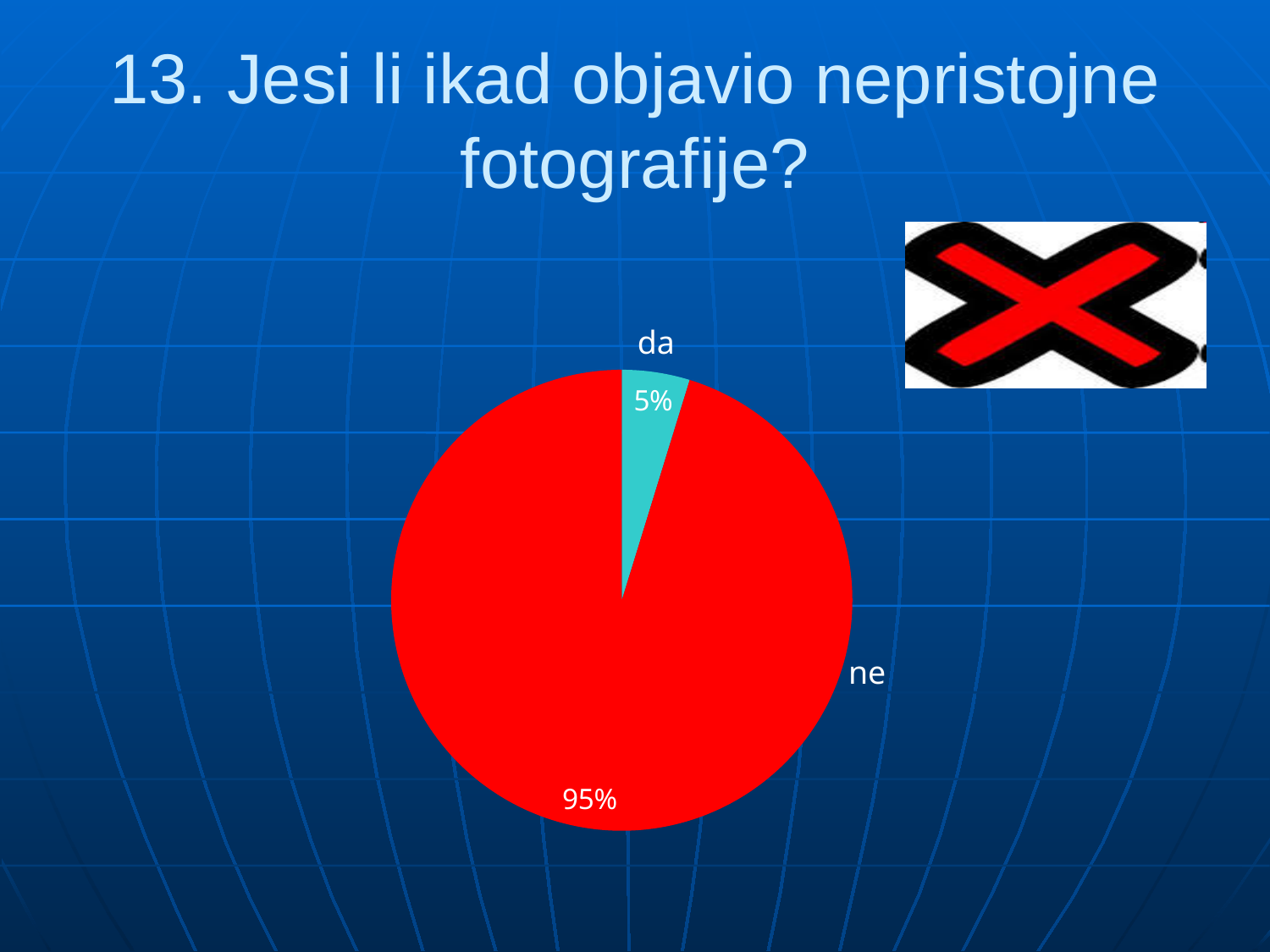
What percentage of the pie is labelled "da"? 5% How many slices does the pie chart have? 2 What is the difference in percentage points between the "ne" slice and the "da" slice? 90 What percentage of the pie is labelled "ne"? 95% What kind of chart is shown on the slide? pie chart Which is larger, the "da" slice or the "ne" slice? ne What colour is the "da" slice of the pie? cyan Which slice of the pie is the smallest? da What colour is the "ne" slice of the pie? red Which slice of the pie is the largest? ne What share of the pie does the "ne" slice represent? 95%